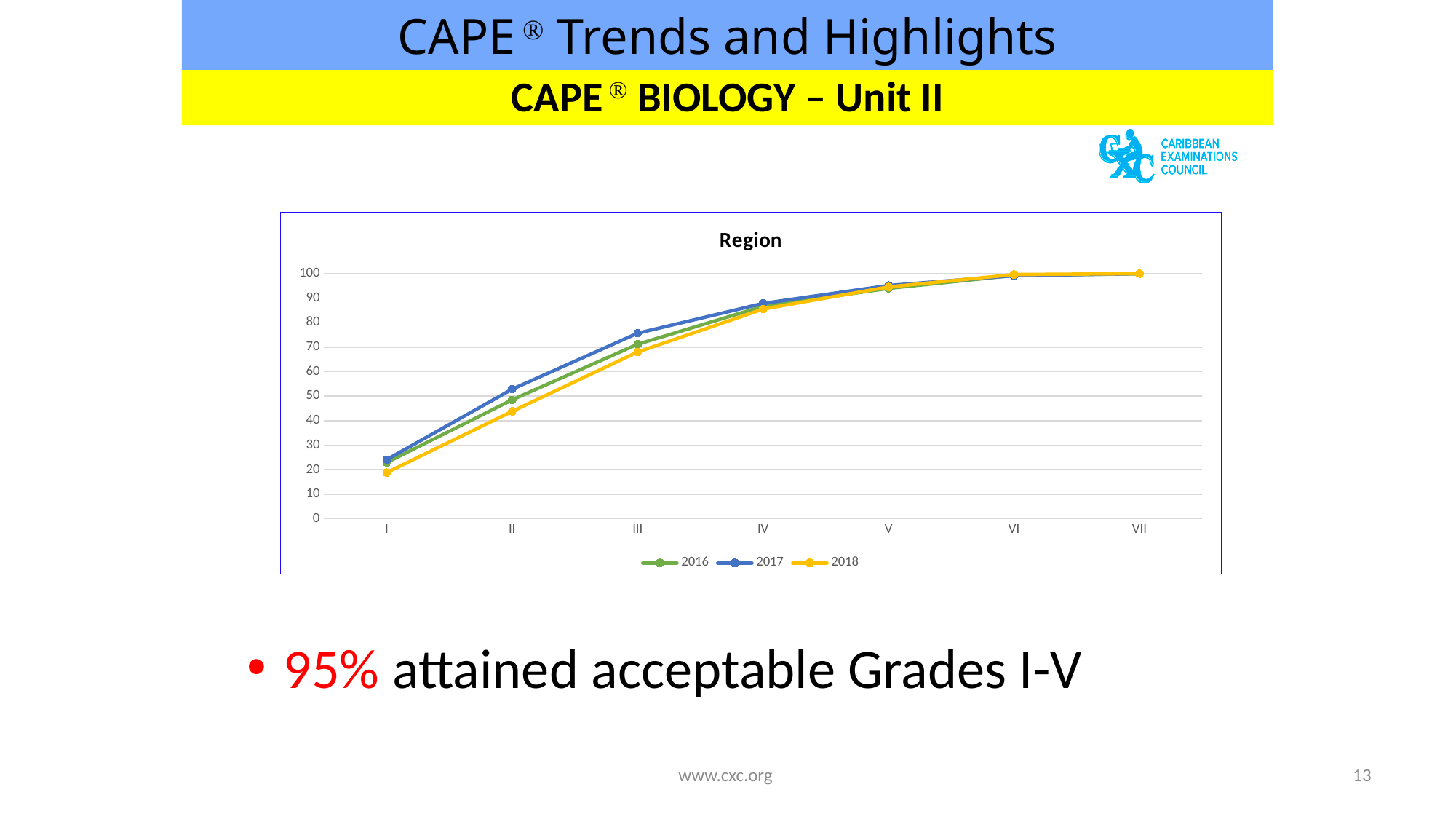
Is the value for 2018 at grade II greater or less than 50? less Is the value for 2017 at grade III greater or less than 70? greater How many grade categories are shown along the x axis of the chart? 7 Is the value for 2016 at grade IV greater or less than 80? greater How many series does the legend of the chart list? 3 What kind of chart is shown on the slide? line chart Do the values for the 2017 series rise or fall from grade I to grade VII? rise At grade III, which series has the larger value, 2016 or 2017? 2017 At grade II, which series has the larger value, 2017 or 2018? 2017 What is the title of the chart? Region Which series has the lowest value at grade II? 2018